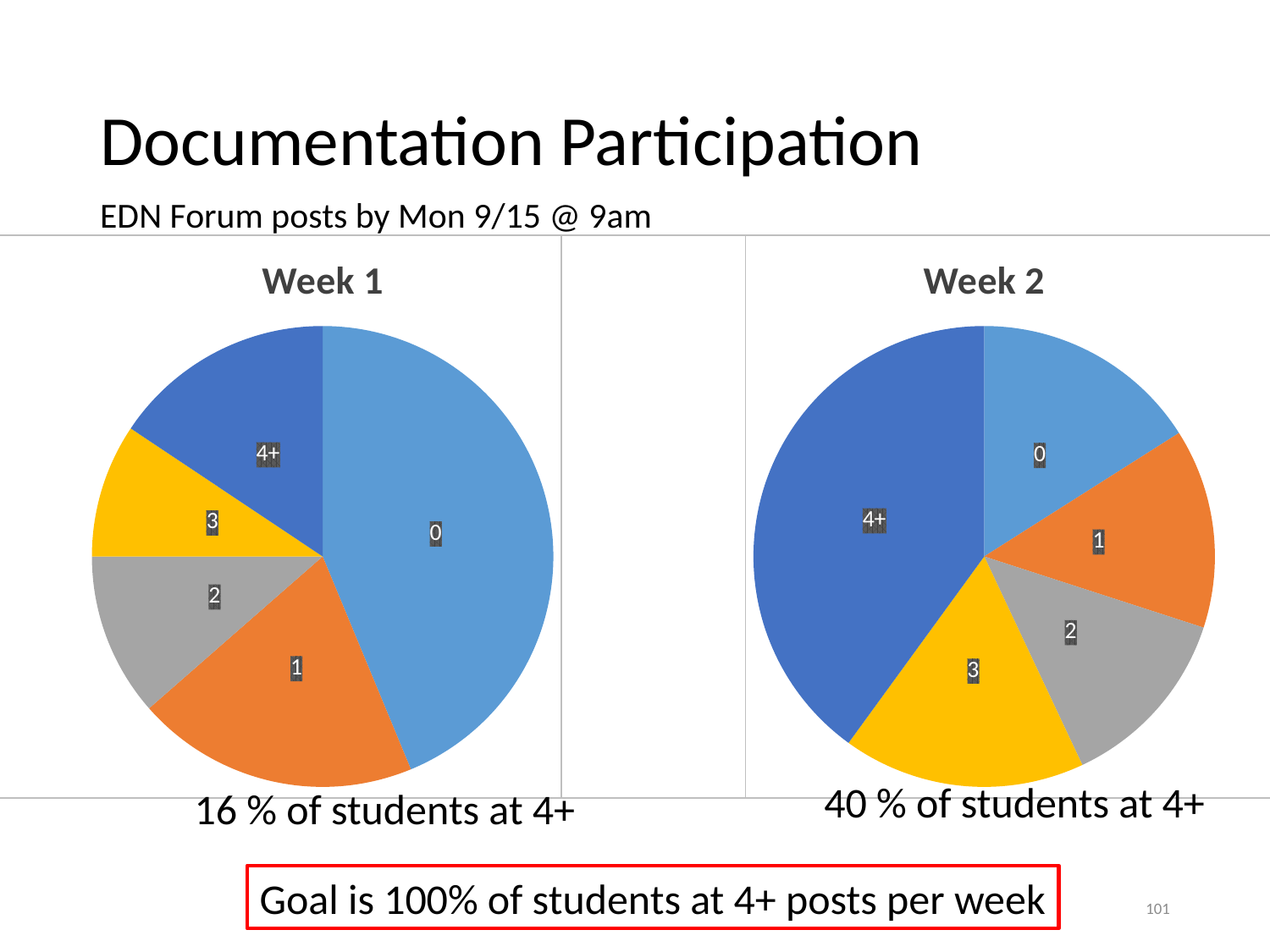
In the Week 1 chart, what share of students are at 4+ posts? 16 % In the Week 1 chart, which category has the largest slice? 0 In the Week 2 chart, which category has the largest slice? 4+ In the Week 2 chart, which slice is larger, 4+ or 2? 4+ By how many percentage points did the share of students at 4+ increase from Week 1 to Week 2? 24 What kind of chart is the Week 1 chart? pie chart In the Week 1 chart, which slice is larger, 0 or 4+? 0 What is the title of the chart on the left? Week 1 In the Week 2 chart, what share of students are at 4+ posts? 40 % In the Week 2 chart, what colour is the 3 slice? yellow Which week's chart has the larger 4+ slice, Week 1 or Week 2? Week 2 How many slices does the Week 2 pie chart have? 5